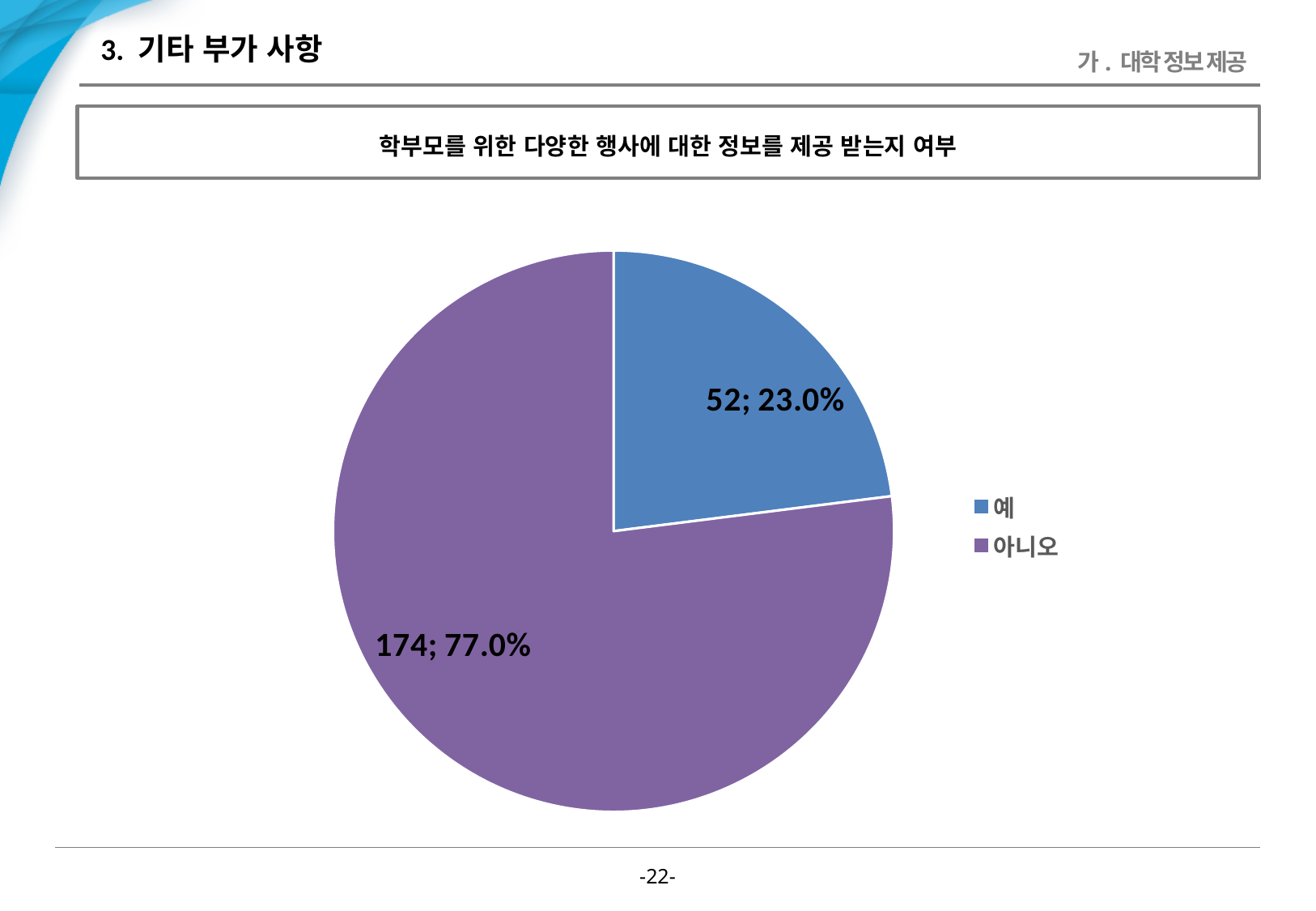
Which category has the largest slice? 아니오 What share of the pie does 아니오 represent? 77.0% What is the count for 아니오? 174 What is the count for 예? 52 How many entries does the legend list? 2 What is the difference between the counts for 아니오 and 예? 122 What share of the pie does 예 represent? 23.0% Which is larger, the count for 예 or the count for 아니오? 아니오 Which category has the smallest slice? 예 How many slices does the pie chart have? 2 What kind of chart is shown on the slide? pie chart What is the total of the two counts shown in the pie chart? 226